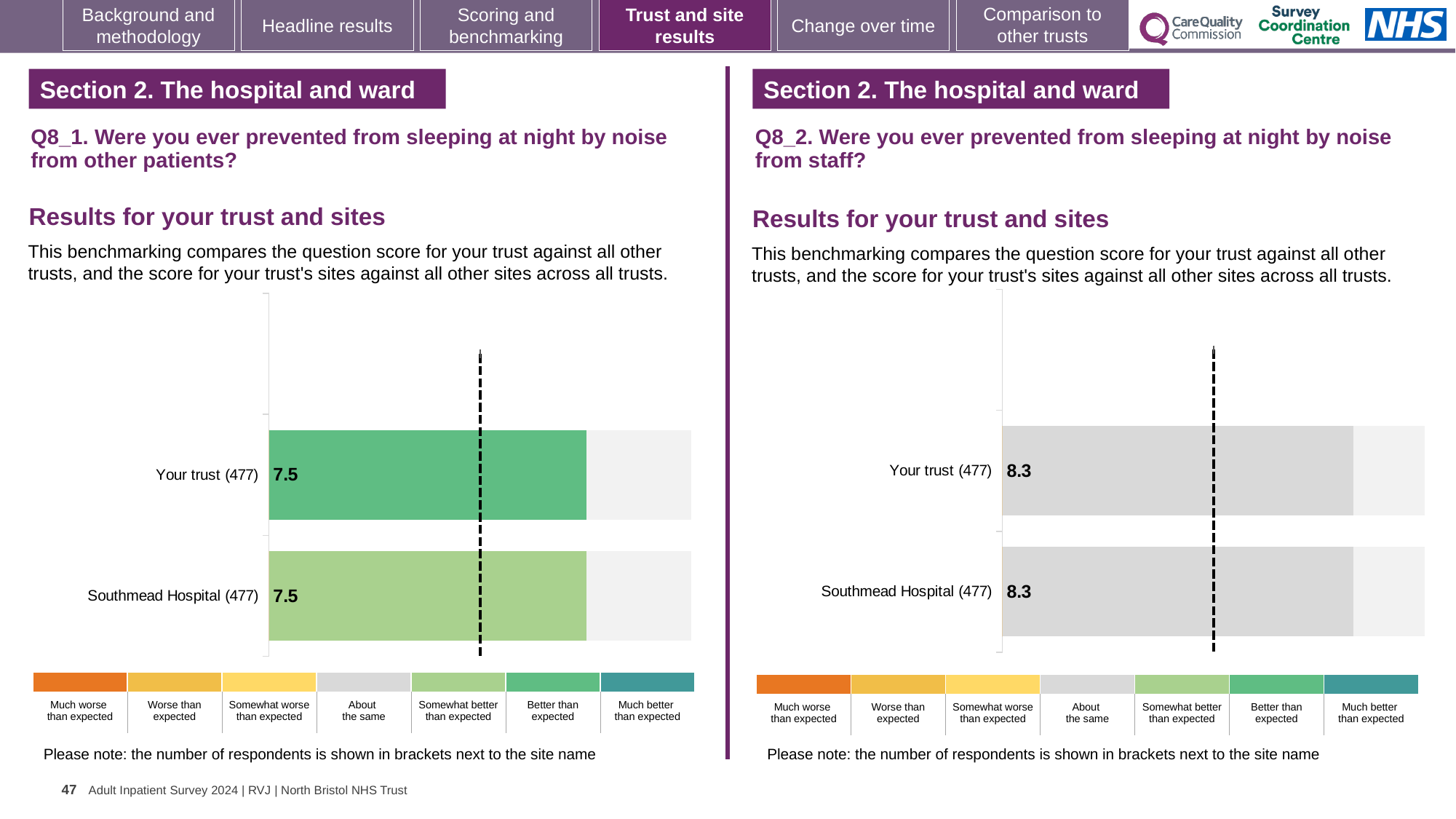
In the Q8_2 chart (noise from staff), what is the score for Your trust (477)? 8.3 In the Q8_1 chart (noise from other patients), what is the score for Your trust (477)? 7.5 How many bars are plotted in the Q8_2 chart (noise from staff)? 2 In the Q8_2 chart (noise from staff), which benchmark category does the grey colour of the bars correspond to in the legend? About the same In the Q8_1 chart (noise from other patients), what is the score for Southmead Hospital (477)? 7.5 What type of chart is used for the Q8_1 results (noise from other patients)? Bar chart In the Q8_1 chart (noise from other patients), what is the difference between the scores for Your trust and Southmead Hospital? 0.0 How many bars are plotted in the Q8_1 chart (noise from other patients)? 2 How many respondents are shown in brackets for Southmead Hospital in the Q8_2 chart (noise from staff)? 477 In the Q8_2 chart (noise from staff), what is the difference between the scores for Your trust and Southmead Hospital? 0.0 In the Q8_1 chart (noise from other patients), which benchmark category does the colour of the Your trust bar correspond to in the legend? Better than expected In the Q8_2 chart (noise from staff), what is the score for Southmead Hospital (477)? 8.3